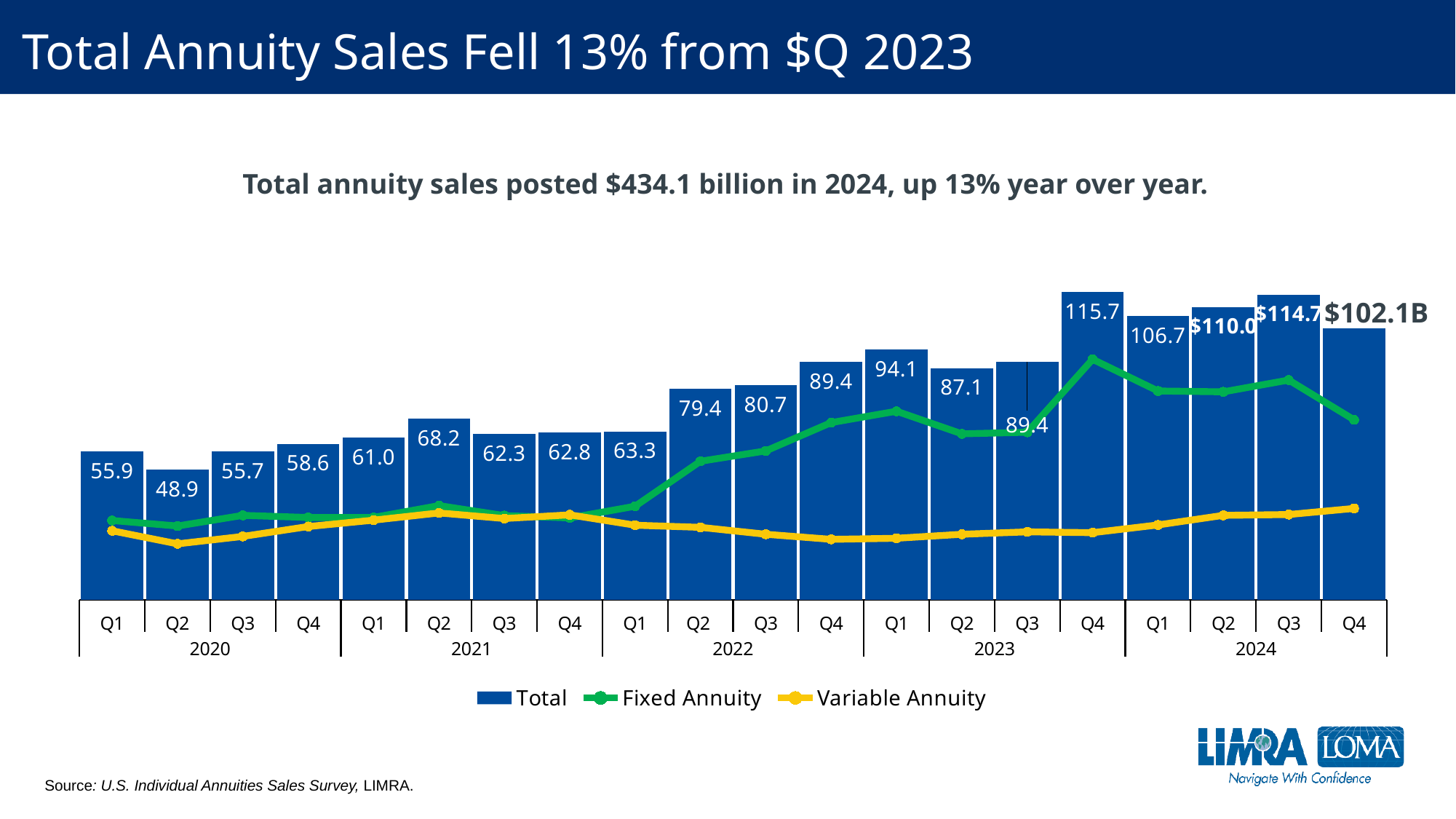
What is the difference between the Total values for Q4 2023 and Q1 2024? 9.0 How many series does the legend list? 3 How many quarterly bars are plotted in the chart? 20 What kind of chart is shown on the slide? A combined bar and line chart What is the Total annuity sales value for Q4 2023? 115.7 Does the Fixed Annuity line generally rise or fall from Q1 2020 to Q4 2023? Rise Which quarter has the highest Total annuity sales bar? Q4 2023 Which is larger, the Total value for Q1 2023 or Q2 2023? Q1 2023 What is the Total annuity sales value for Q3 2024? $114.7 Which quarter has the lowest Total annuity sales bar? Q2 2020 What is the Total annuity sales value for Q4 2024? $102.1B What is the Total annuity sales value for Q2 2020? 48.9